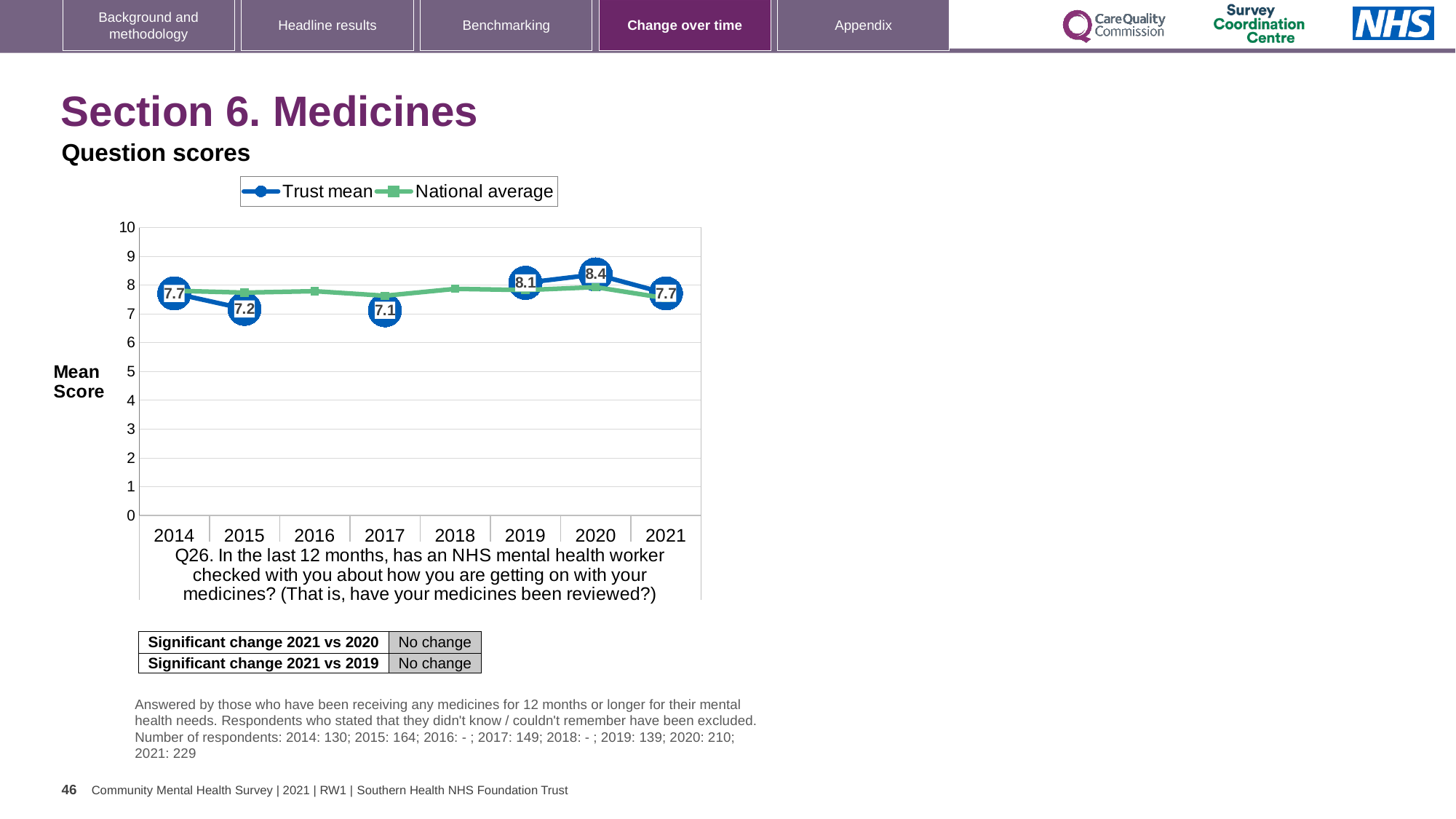
What is the Trust mean score for 2020? 8.4 In which year is the Trust mean score lowest? 2017 Is the National average value for 2018 greater or less than 7? greater How many series does the legend list? 2 In which year is the Trust mean score highest? 2020 What is the Trust mean score for 2017? 7.1 Does the Trust mean score rise or fall from 2020 to 2021? Fall What kind of chart is shown on the slide? Line chart What is the Trust mean score for 2021? 7.7 Which is larger, the Trust mean score in 2014 or in 2015? 2014 How many years are shown on the x axis? 8 What is the difference between the Trust mean score in 2020 and in 2021? 0.7